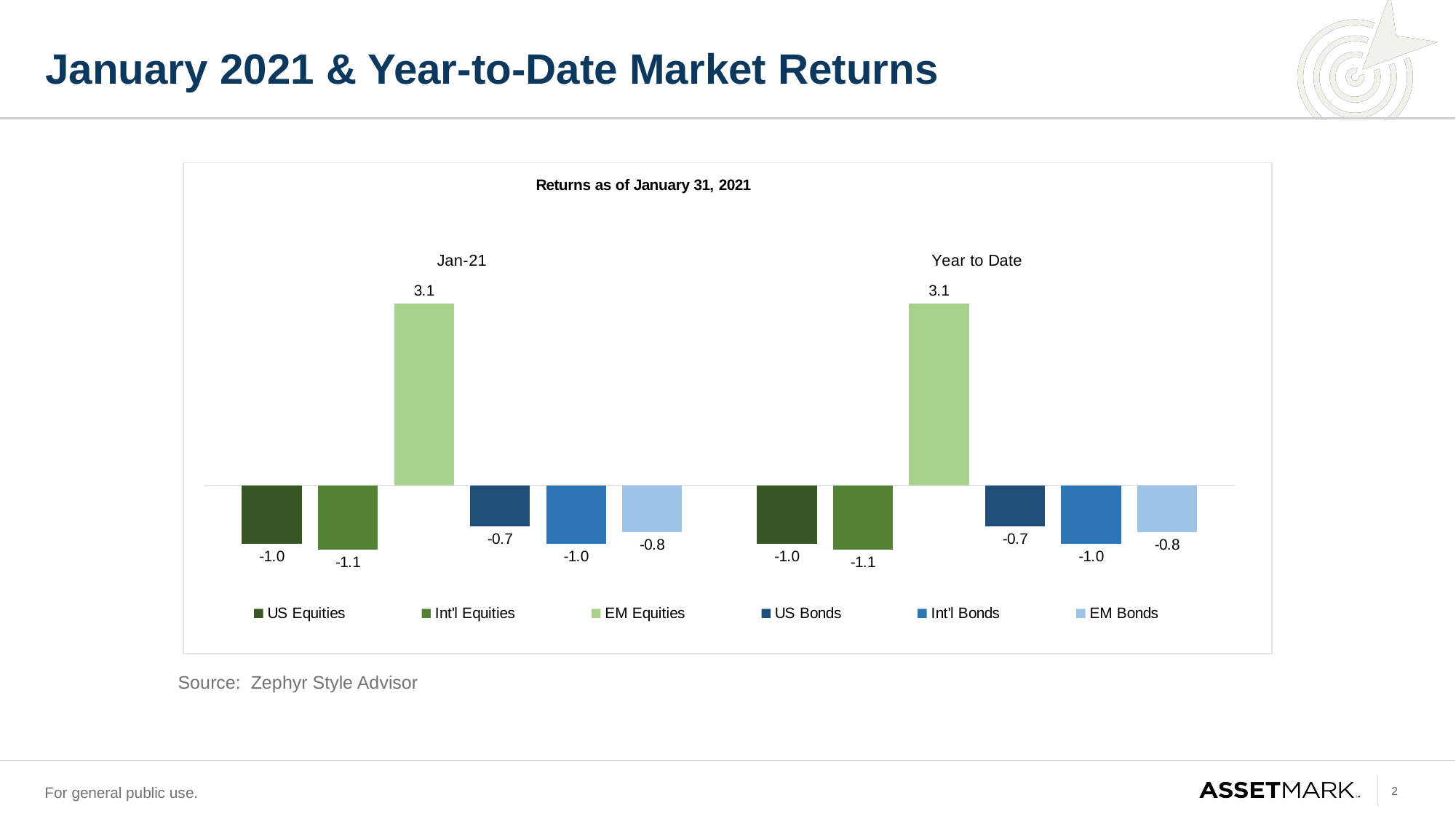
What kind of chart is shown? Bar chart In the Year to Date group, which is larger: the value for US Bonds or the value for Int'l Bonds? US Bonds Which series has the lowest value in the Year to Date group? Int'l Equities Which series has the highest value in the Jan-21 group? EM Equities What is the value for Int'l Equities in the Year to Date group? -1.1 What is the value for EM Equities in the Jan-21 group? 3.1 What is the value for EM Bonds in the Year to Date group? -0.8 What is the value for US Bonds in the Jan-21 group? -0.7 What is the title of the chart? Returns as of January 31, 2021 How many category groups are shown on the x axis? 2 What is the difference between the EM Equities value and the US Equities value in the Jan-21 group? 4.1 How many series does the legend list? 6